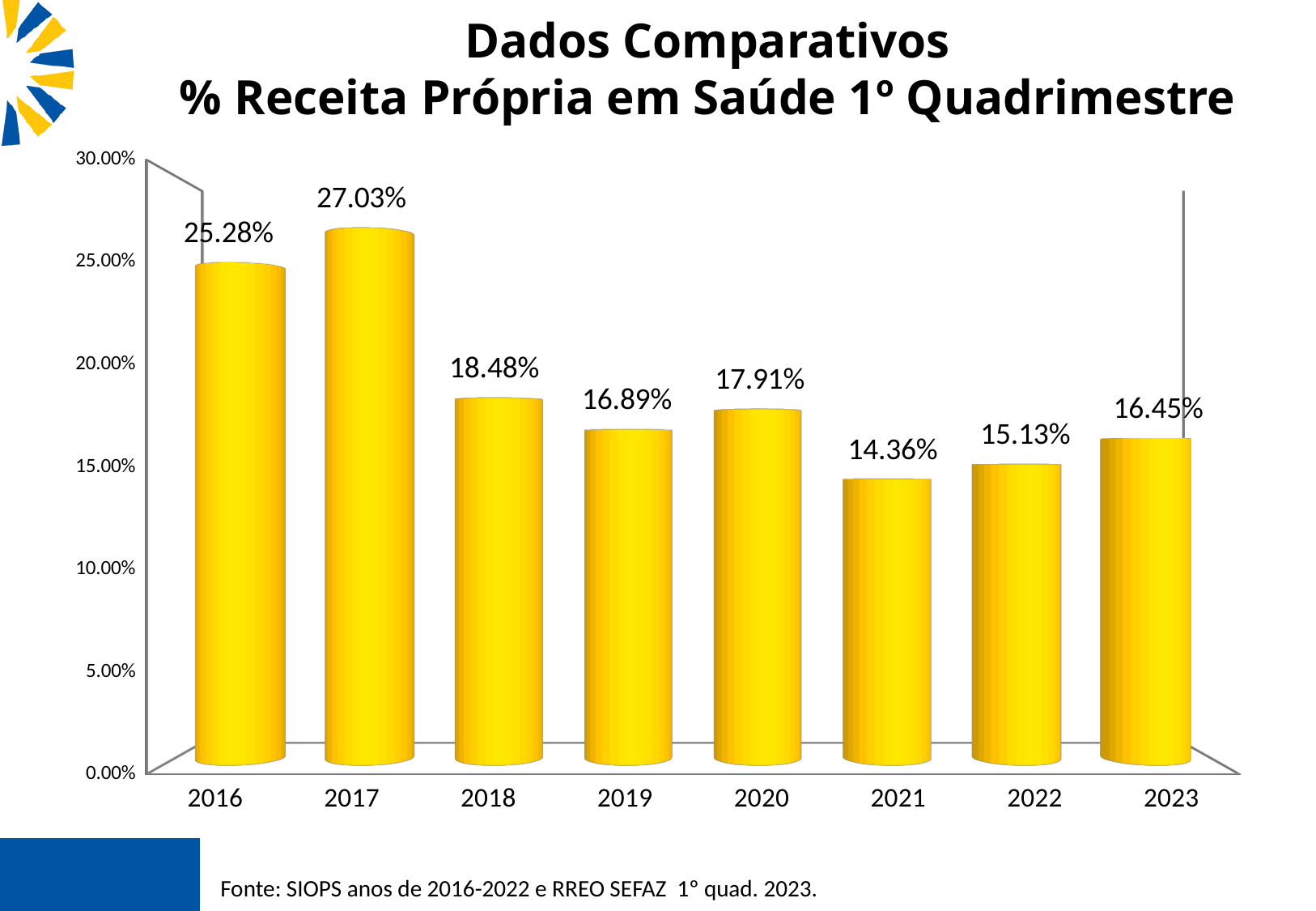
What is the difference between the values for 2022 and 2023? 1.32% Which year has the highest value? 2017 What is the value for 2021? 14.36% What kind of chart is shown on the slide? bar chart What is the difference between the values for 2016 and 2017? 1.75% Is the value for 2018 greater or less than 20.00%? less Which is larger, the value for 2019 or the value for 2020? 2020 What is the value for 2023? 16.45% How many years are shown on the x axis? 8 What is the value for 2017? 27.03% What is the title of the chart? Dados Comparativos % Receita Própria em Saúde 1º Quadrimestre Which year has the lowest value? 2021